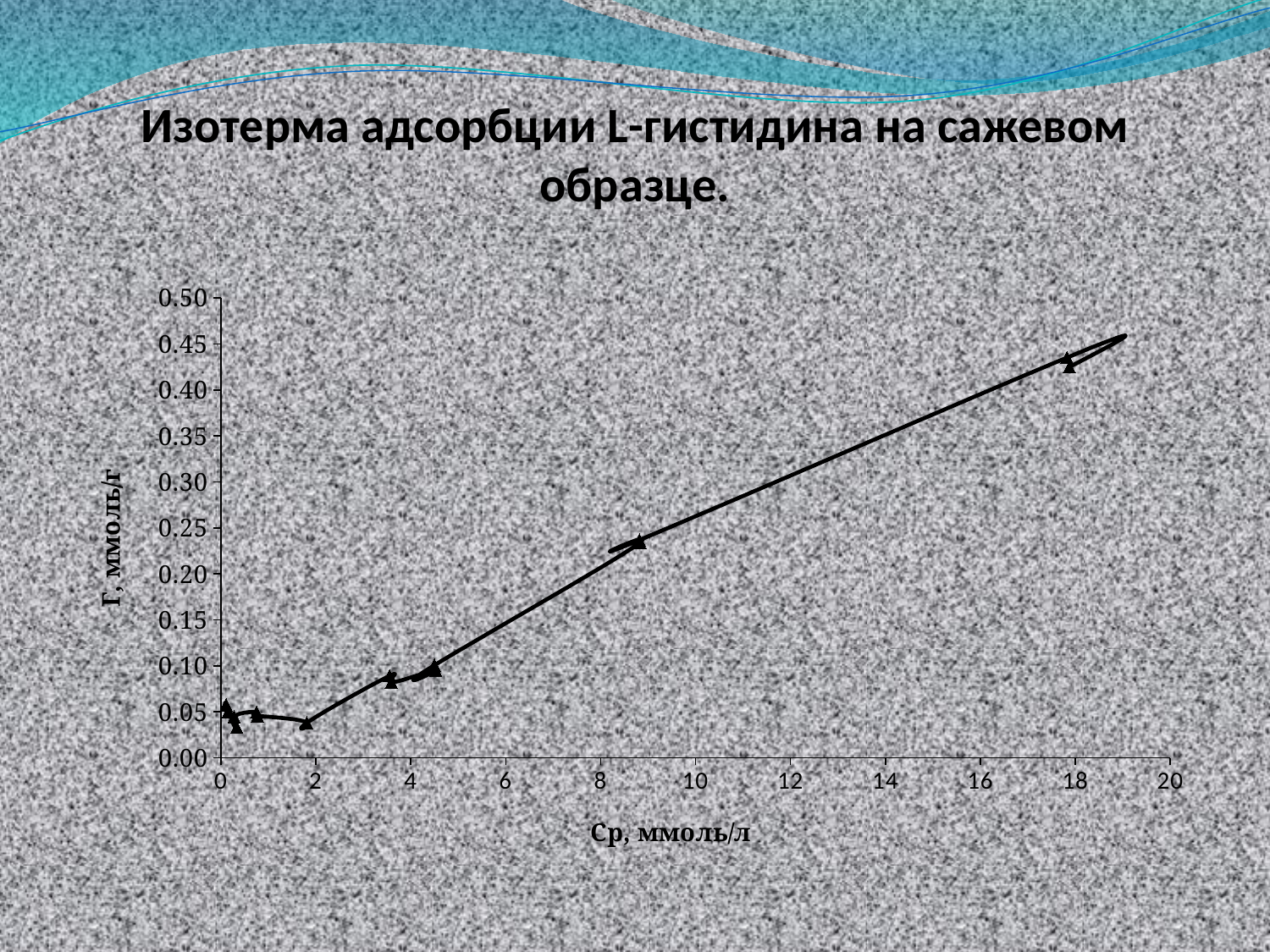
Is the largest Ср value plotted greater or less than 16? greater Is the value of Г for the point near Ср = 18 greater or less than 0.40? greater What kind of chart is shown on the slide? line chart Is the value of Г for the point near Ср = 9 greater or less than 0.20? greater What is the maximum value shown on the y axis? 0.50 What is the title of the chart? Изотерма адсорбции L-гистидина на сажевом образце. What is the label of the x axis? Ср, ммоль/л Overall, do the values rise or fall as Ср increases along the x axis? rise Which point has the higher Г value: the one near Ср = 9 or the one near Ср = 18? the one near Ср = 18